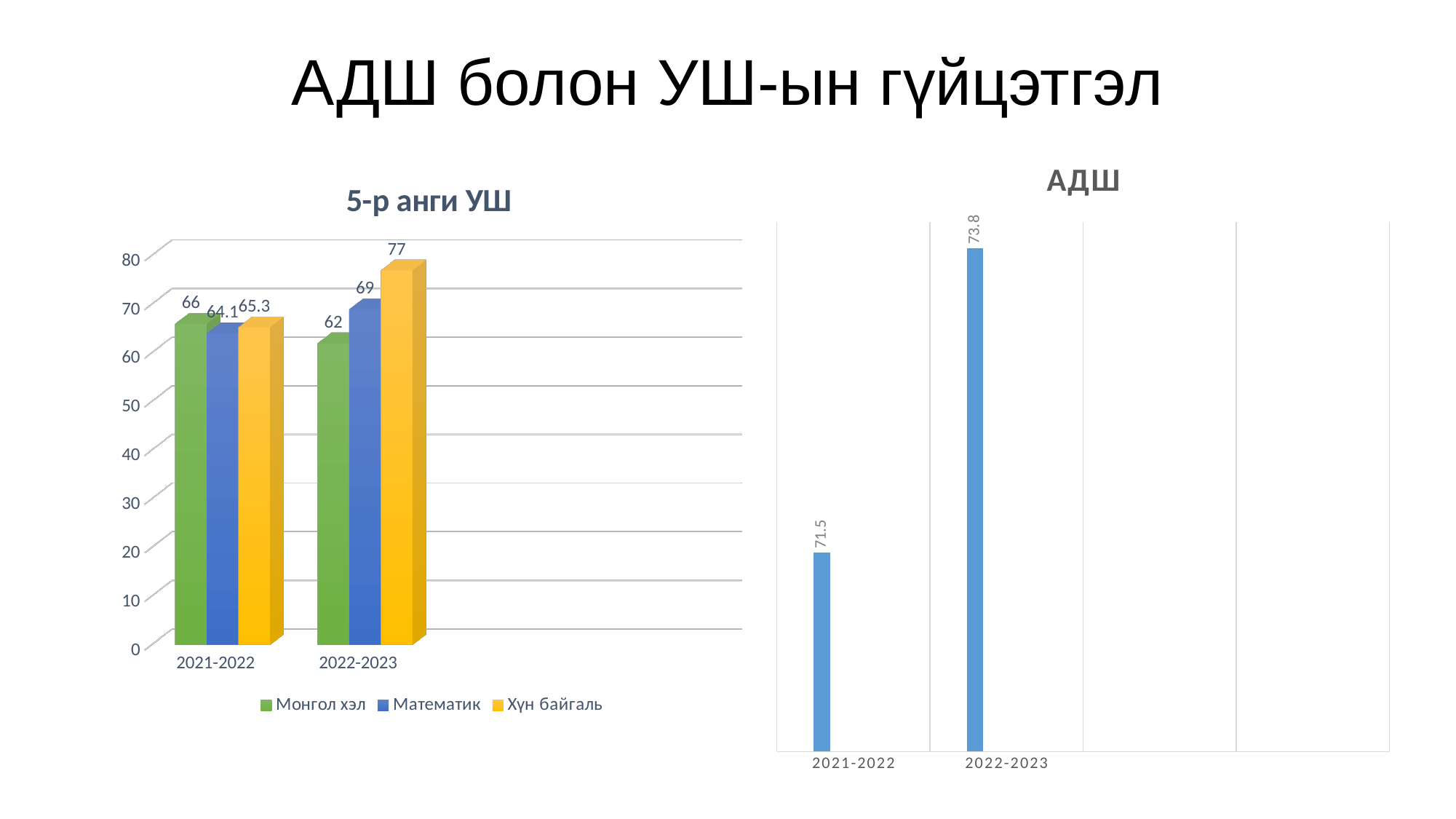
In the '5-р анги УШ' chart, what is the value for Математик in 2021-2022? 64.1 What kind of chart is the 'АДШ' chart? bar chart In the 'АДШ' chart, do the values rise or fall from 2021-2022 to 2022-2023? rise In the '5-р анги УШ' chart, which series has the lowest value in 2022-2023? Монгол хэл In the '5-р анги УШ' chart, what is the value for Хүн байгаль in 2022-2023? 77 In the '5-р анги УШ' chart, which series has the highest value in 2022-2023? Хүн байгаль In the 'АДШ' chart, what is the difference between the 2022-2023 and 2021-2022 values? 2.3 How many series does the legend of the '5-р анги УШ' chart list? 3 In the '5-р анги УШ' chart, what is the value for Монгол хэл in 2021-2022? 66 In the '5-р анги УШ' chart, which is larger: Монгол хэл in 2021-2022 or Монгол хэл in 2022-2023? 2021-2022 In the '5-р анги УШ' chart, what is the difference between the Математик values for 2022-2023 and 2021-2022? 4.9 In the 'АДШ' chart, what is the value for 2022-2023? 73.8